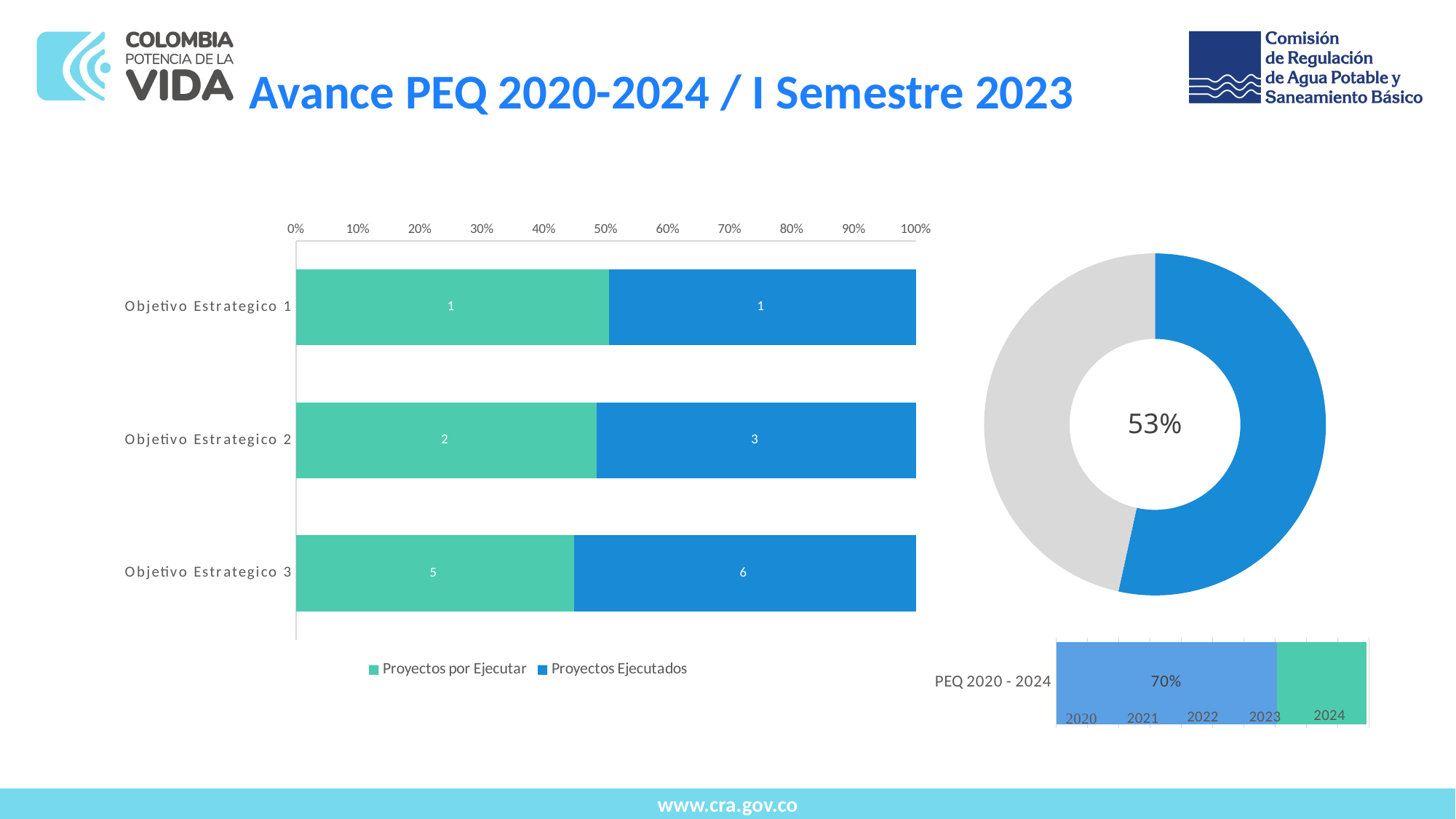
In the stacked bar chart on the left, what is the value of Proyectos por Ejecutar for Objetivo Estrategico 2? 2 What percentage is shown in the centre of the donut chart on the right? 53% In the stacked bar chart on the left, which objective has the highest value for Proyectos Ejecutados? Objetivo Estrategico 3 How many categories are shown in the stacked bar chart on the left? 3 In the stacked bar chart on the left, what is the difference between Proyectos Ejecutados and Proyectos por Ejecutar for Objetivo Estrategico 3? 1 In the small bar at the bottom right labelled PEQ 2020 - 2024, what percentage is printed on the bar? 70% In the stacked bar chart on the left, for Objetivo Estrategico 2, which is larger: Proyectos Ejecutados or Proyectos por Ejecutar? Proyectos Ejecutados How many series does the legend of the stacked bar chart on the left list? 2 In the stacked bar chart on the left, what is the total of the two segments for Objetivo Estrategico 3? 11 What kind of chart is the chart on the left of the slide? Bar chart In the stacked bar chart on the left, what is the value of Proyectos Ejecutados for Objetivo Estrategico 3? 6 In the stacked bar chart on the left, which objective has the lowest value for Proyectos por Ejecutar? Objetivo Estrategico 1